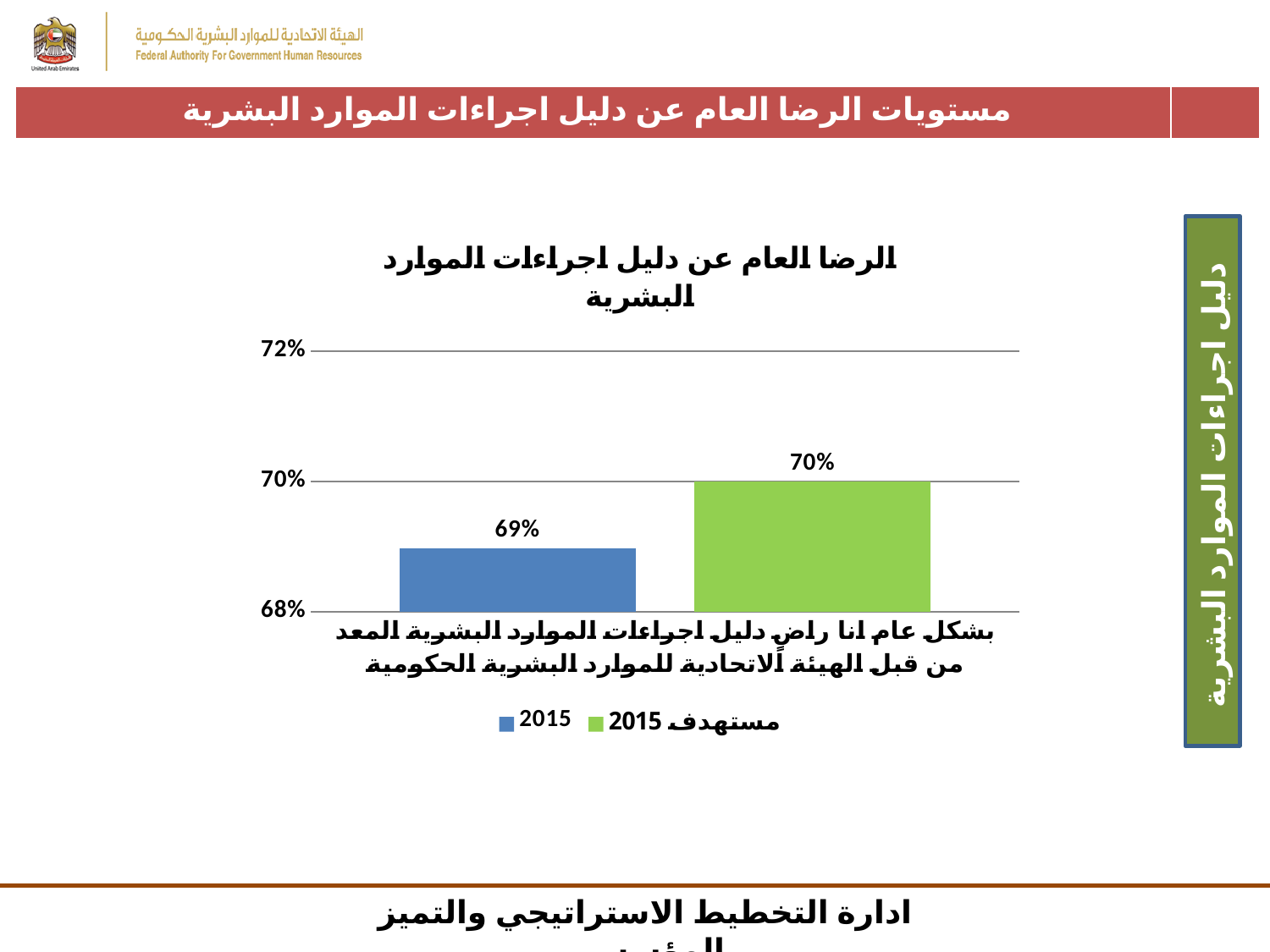
How many bars are plotted in the chart? 2 Is the value for 2015 greater or less than 70%? less Is the 2015 value larger or smaller than the مستهدف 2015 value? smaller What colour is the bar for مستهدف 2015? green Which series has the lower value, 2015 or مستهدف 2015? 2015 What is the value of the مستهدف 2015 (target 2015) bar? 70% How many series does the legend list? 2 What is the value of the 2015 bar? 69% What is the difference between the مستهدف 2015 value and the 2015 value? 1% Is the value for مستهدف 2015 greater or less than 72%? less Which series has the higher value, 2015 or مستهدف 2015? مستهدف 2015 What kind of chart is shown on the slide? bar chart